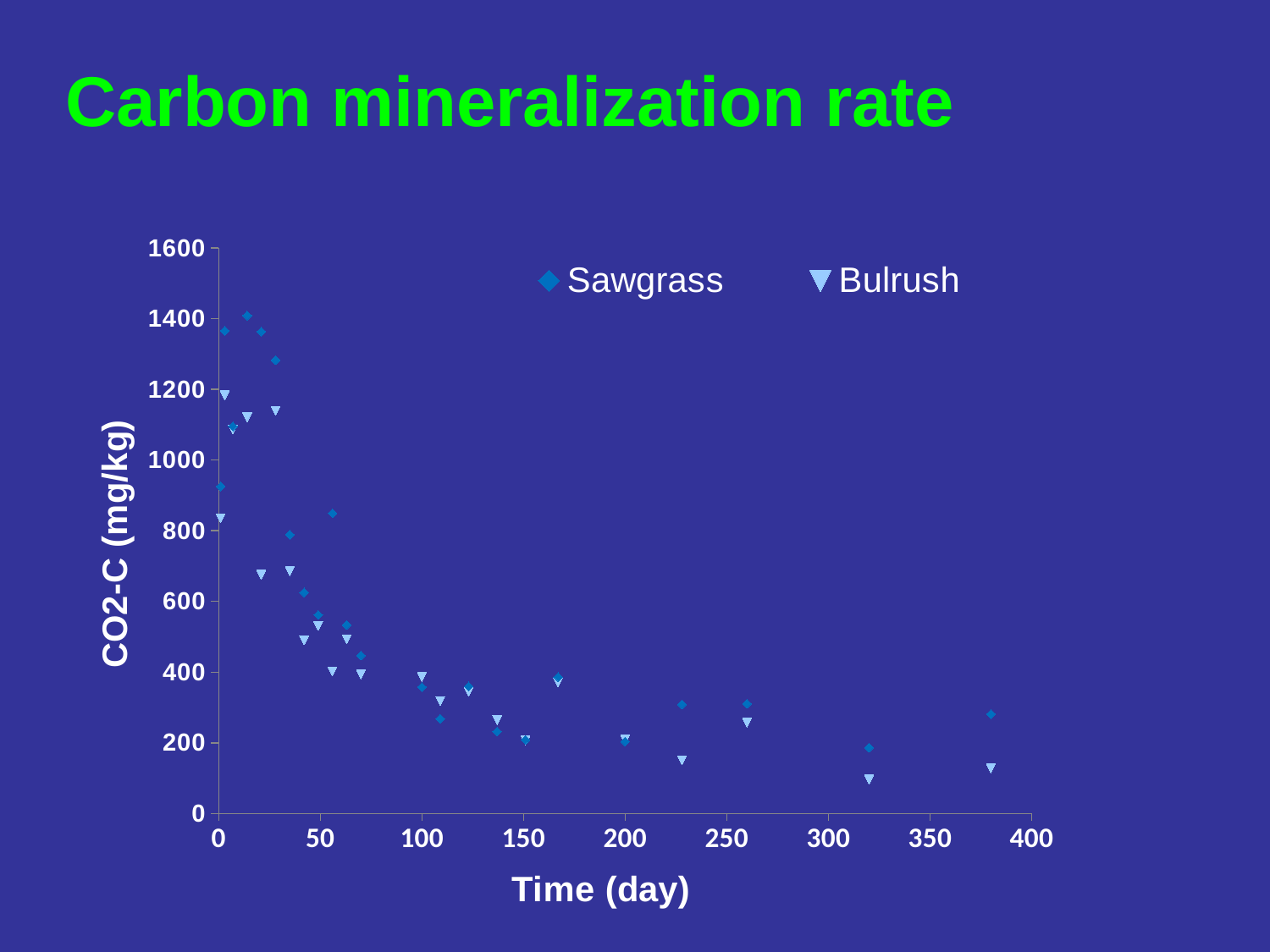
What kind of chart is shown on the slide? scatter chart How many series does the legend list? 2 What is the title of the chart? Carbon mineralization rate At around day 15, which series has the larger CO2-C value, Sawgrass or Bulrush? Sawgrass Is the peak Sawgrass value greater or less than 1200? greater Overall, do the CO2-C values rise or fall as time increases along the x axis? fall Which two series are shown in the legend? Sawgrass and Bulrush Is the Bulrush value at around day 320 greater or less than 200? less Which series reaches the highest CO2-C value on the chart? Sawgrass Is the Sawgrass value at around day 380 greater or less than 200? greater Which series has the lowest CO2-C value on the chart? Bulrush At around day 320, which series has the larger CO2-C value, Sawgrass or Bulrush? Sawgrass